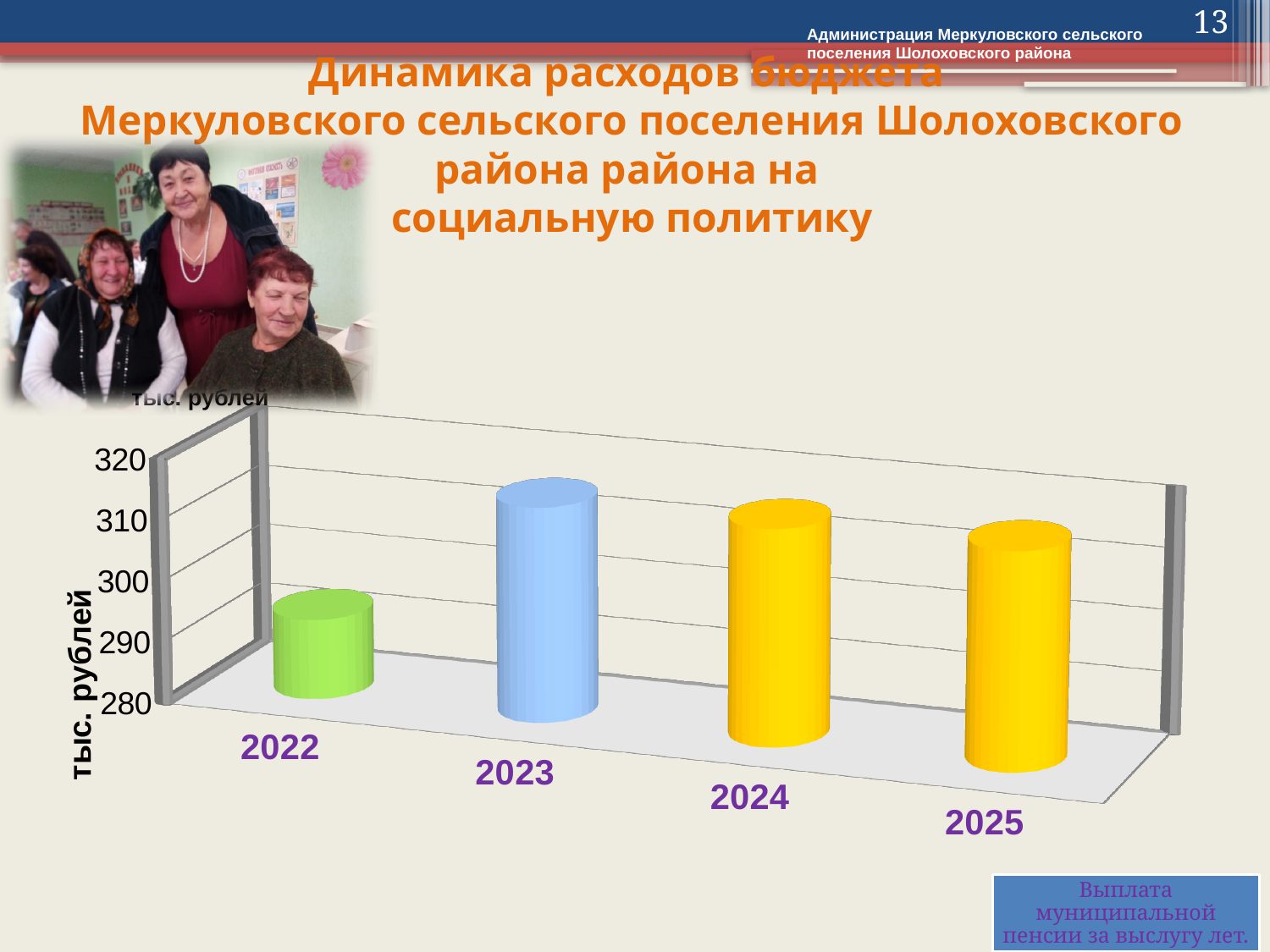
Is the value for 2025 greater or less than 300? greater How many years are shown on the x axis of the chart? 4 What kind of chart is shown on the slide? bar chart Is the value for 2023 greater or less than 310? greater Is the value for 2024 greater or less than 300? greater Which is larger, the value for 2022 or the value for 2025? 2025 Which year has the lowest value in the chart? 2022 Does the value rise or fall from 2022 to 2023? rise What unit is given on the vertical axis of the chart? тыс. рублей Which is larger, the value for 2022 or the value for 2023? 2023